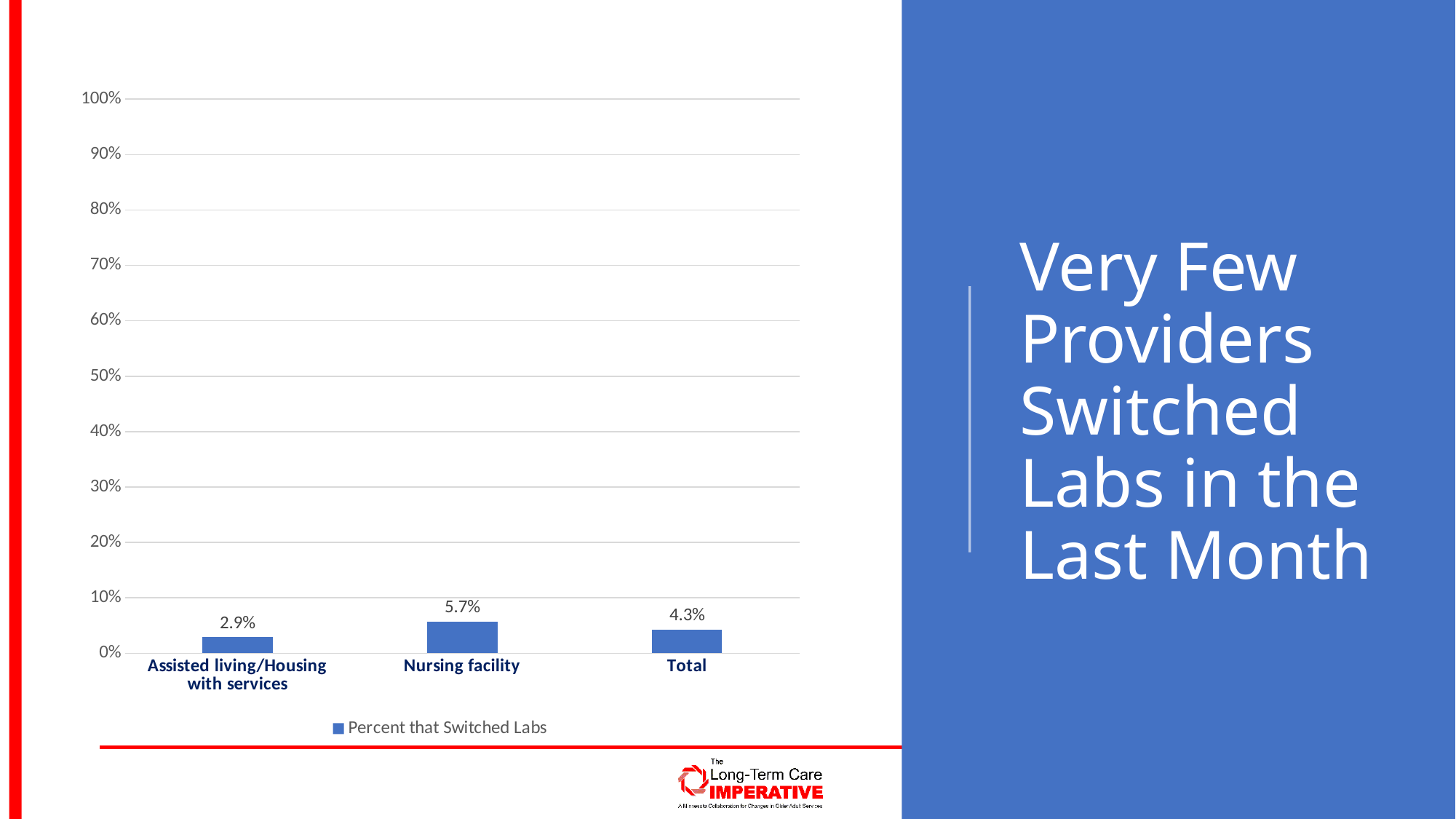
Which category has the highest percent that switched labs? Nursing facility What kind of chart is shown on the slide? bar chart What is the legend entry for the series shown? Percent that Switched Labs Which is larger, the value for Total or the value for Assisted living/Housing with services? Total What is the difference between the Nursing facility value and the Assisted living/Housing with services value? 2.8% What is the value for Nursing facility? 5.7% What is the value for Total? 4.3% What is the value for Assisted living/Housing with services? 2.9% How many categories are shown on the x axis? 3 Is the value for Nursing facility greater or less than 10%? less How many series does the legend list? 1 Which category has the lowest percent that switched labs? Assisted living/Housing with services